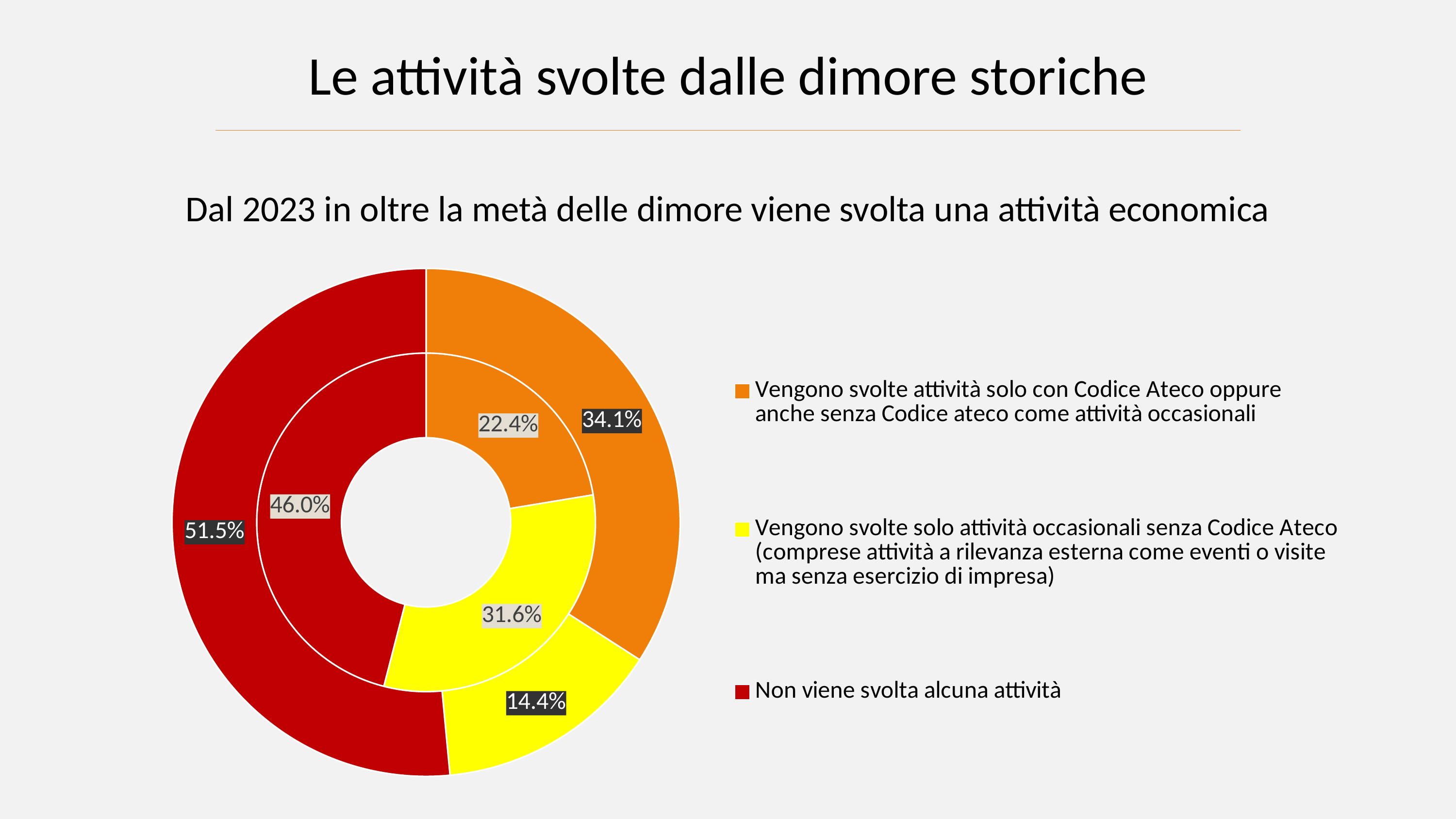
What kind of chart is shown on the slide? Doughnut chart In the outer ring, what is the value for "Vengono svolte attività solo con Codice Ateco oppure anche senza Codice ateco come attività occasionali"? 34.1% What colour represents "Non viene svolta alcuna attività" in the chart? Red How many entries does the legend list? 3 Which is larger: the inner-ring value for "Vengono svolte solo attività occasionali senza Codice Ateco" or the outer-ring value for the same category? The inner-ring value (31.6%) Which category has the smallest share in the inner ring? Vengono svolte attività solo con Codice Ateco oppure anche senza Codice ateco come attività occasionali In the outer ring, what is the value for "Vengono svolte solo attività occasionali senza Codice Ateco"? 14.4% In the inner ring, what is the value for "Non viene svolta alcuna attività"? 46.0% In the outer ring, what is the value for "Non viene svolta alcuna attività"? 51.5% What is the difference between the outer-ring and inner-ring values for "Non viene svolta alcuna attività"? 5.5% Which category has the largest share in the outer ring? Non viene svolta alcuna attività In the inner ring, what is the value for "Vengono svolte solo attività occasionali senza Codice Ateco"? 31.6%